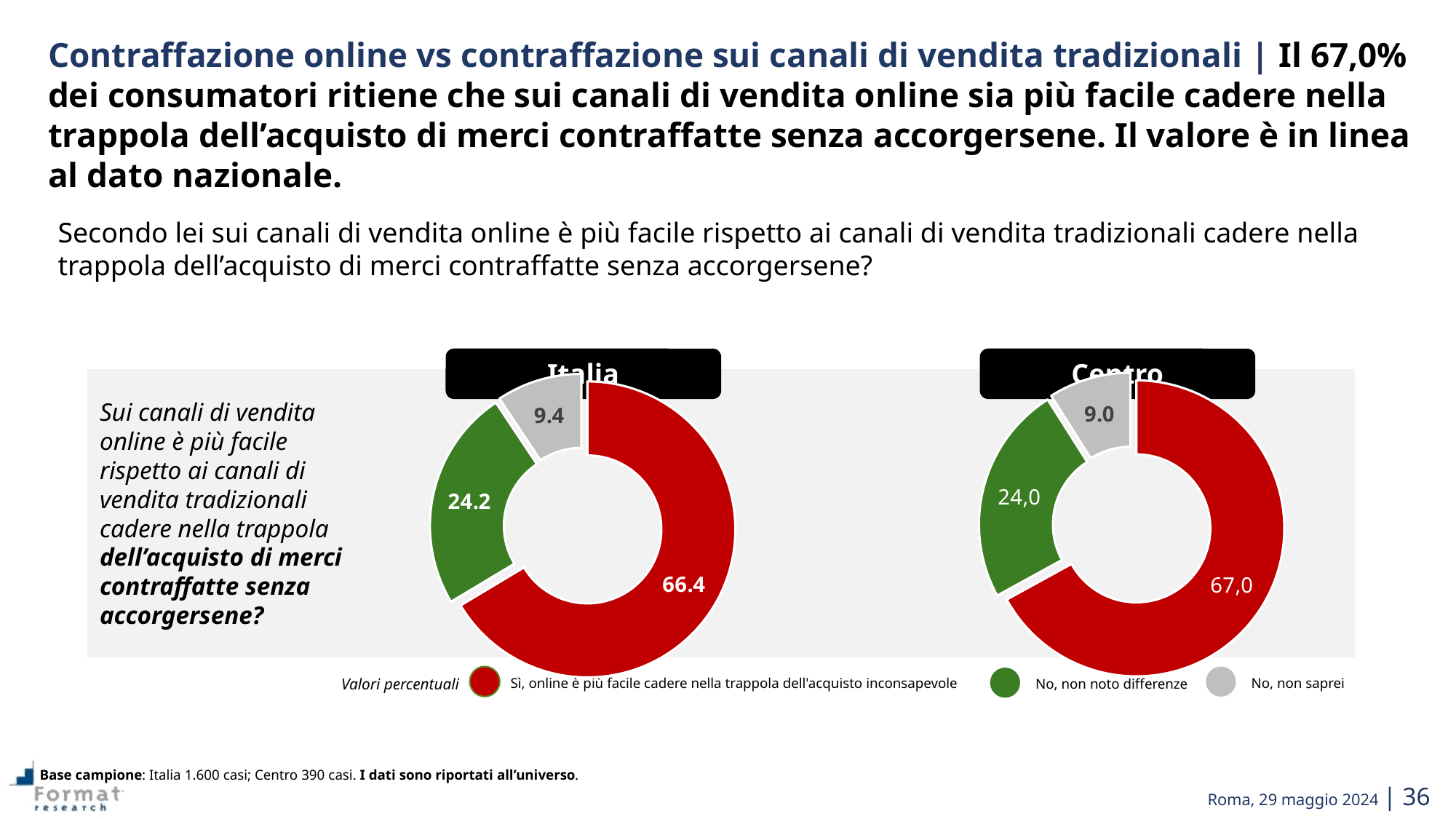
In the Centro chart, which category has the largest share? Sì, online è più facile cadere nella trappola dell'acquisto inconsapevole In the Centro chart, what is the value for "Sì, online è più facile cadere nella trappola dell'acquisto inconsapevole"? 67,0 In the Italia chart, what is the value for "No, non saprei"? 9.4 What kind of chart is used for Italia and Centro? Donut (pie) chart In the Italia chart, which category has the smallest share? No, non saprei How many categories does each donut chart show? 3 What colour represents "No, non noto differenze" in the charts? Green In the Italia chart, what is the difference between the "Sì" value and the "No, non noto differenze" value? 42.2 How many entries does the legend list? 3 In the Centro chart, what is the value for "No, non noto differenze"? 24,0 Which is larger: the "No, non saprei" value in the Italia chart or in the Centro chart? Italia In the Italia chart, what is the value for "Sì, online è più facile cadere nella trappola dell'acquisto inconsapevole"? 66.4